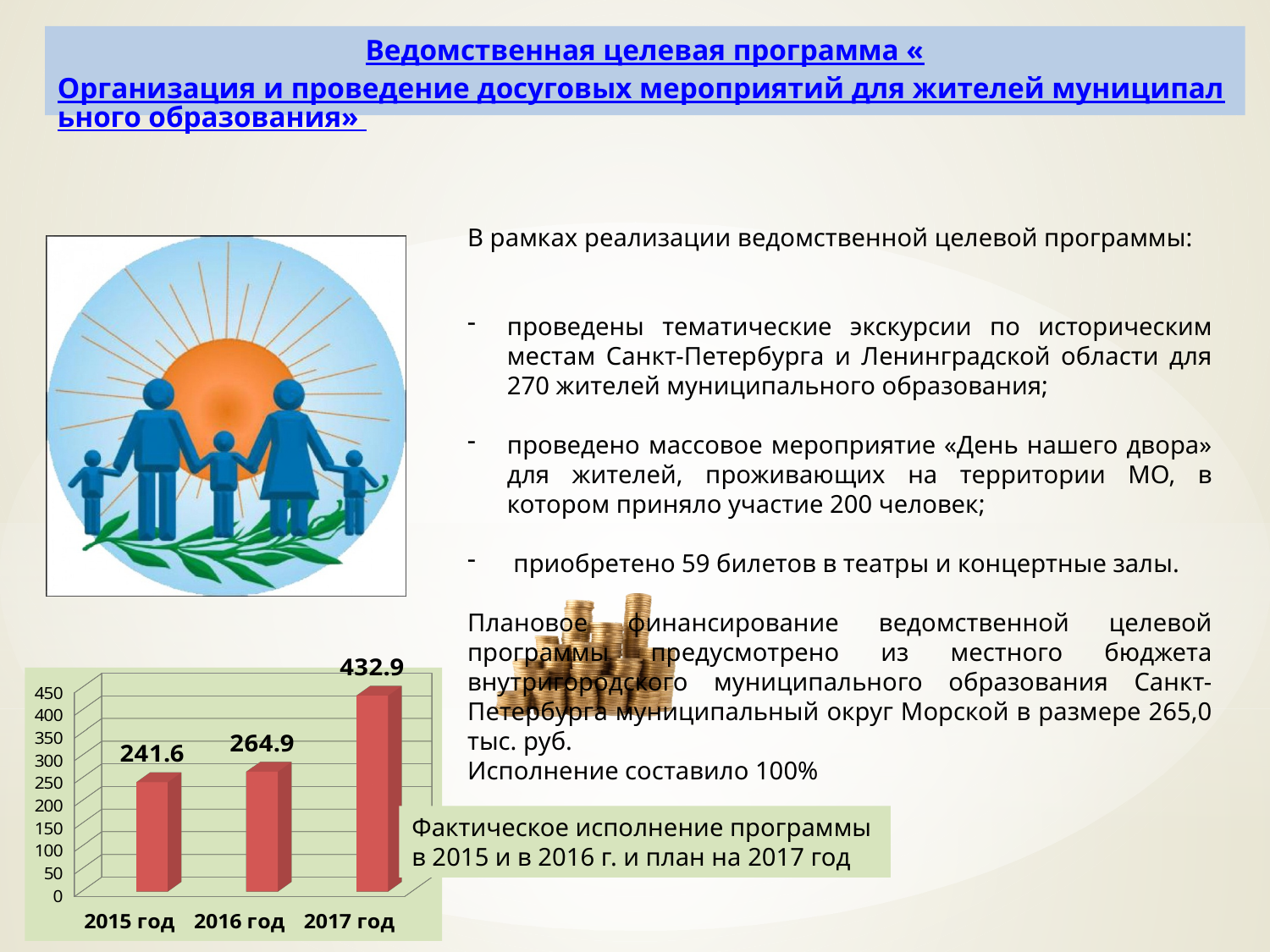
Which is larger, the value for 2016 год or the value for 2015 год? 2016 год What is the value shown for 2015 год? 241.6 Do the values rise or fall from 2015 год to 2017 год? rise Which year has the lowest value in the chart? 2015 год Is the value for 2017 год greater or less than 400? greater What is the value shown for 2017 год? 432.9 Which year has the highest value in the chart? 2017 год What is the difference between the values for 2016 год and 2015 год? 23.3 What kind of chart is shown on the slide? bar chart What is the value shown for 2016 год? 264.9 How many years (categories) are shown in the chart? 3 What is the difference between the values for 2017 год and 2016 год? 168.0